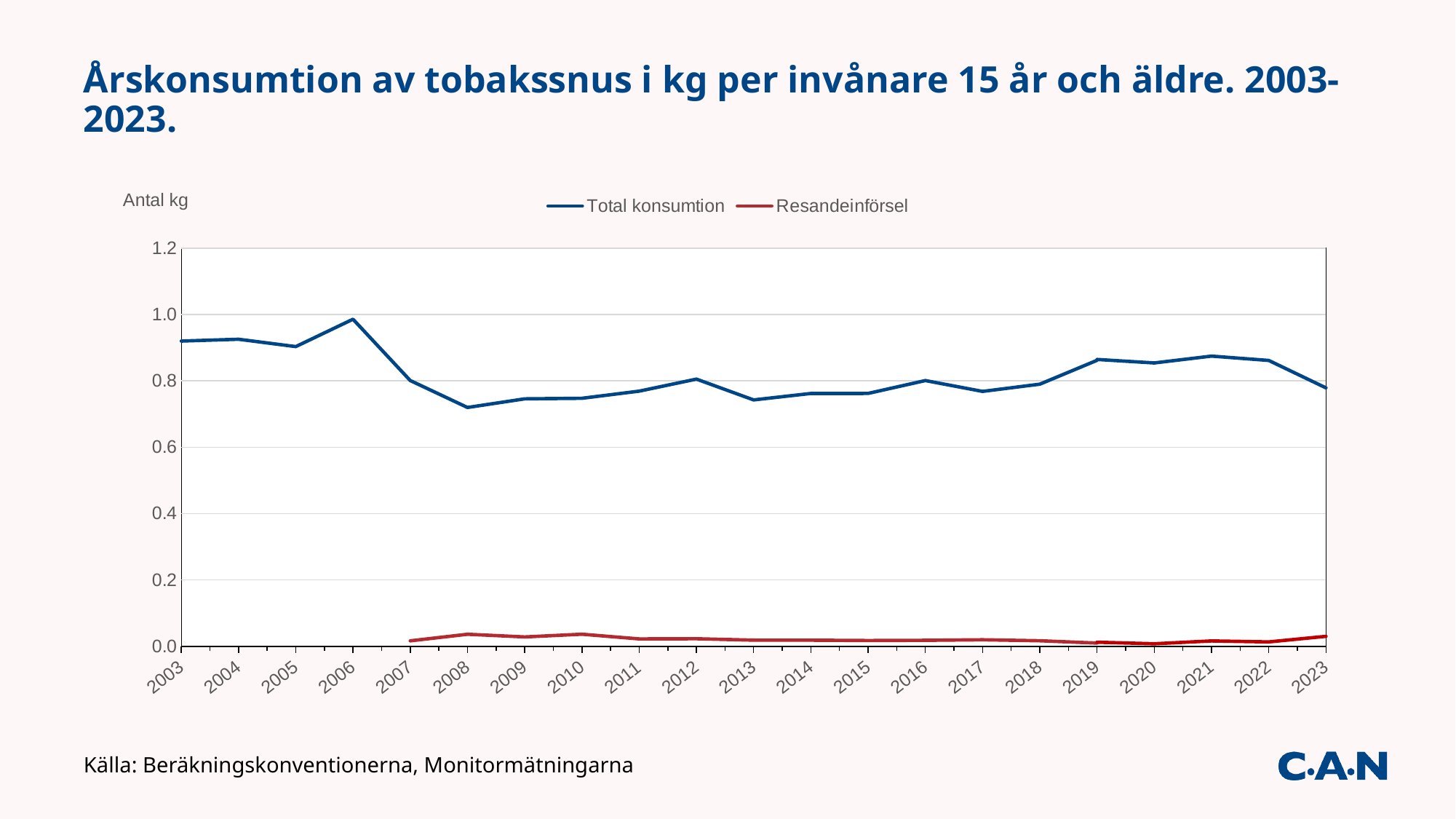
Which is larger, Total konsumtion in 2019 or in 2013? 2019 How many years are shown on the x axis? 21 Which is larger, Total konsumtion in 2006 or in 2008? 2006 What kind of chart is shown on the slide? line chart In which year is Total konsumtion highest? 2006 Does Total konsumtion rise or fall from 2006 to 2008? fall Is the value for Total konsumtion in 2006 greater or less than 0.8? greater How many series does the legend list? 2 Is the value for Total konsumtion in 2008 greater or less than 0.8? less Is the value for Resandeinförsel in 2010 greater or less than 0.2? less In which year is Total konsumtion lowest? 2008 What colour is the Resandeinförsel line? red